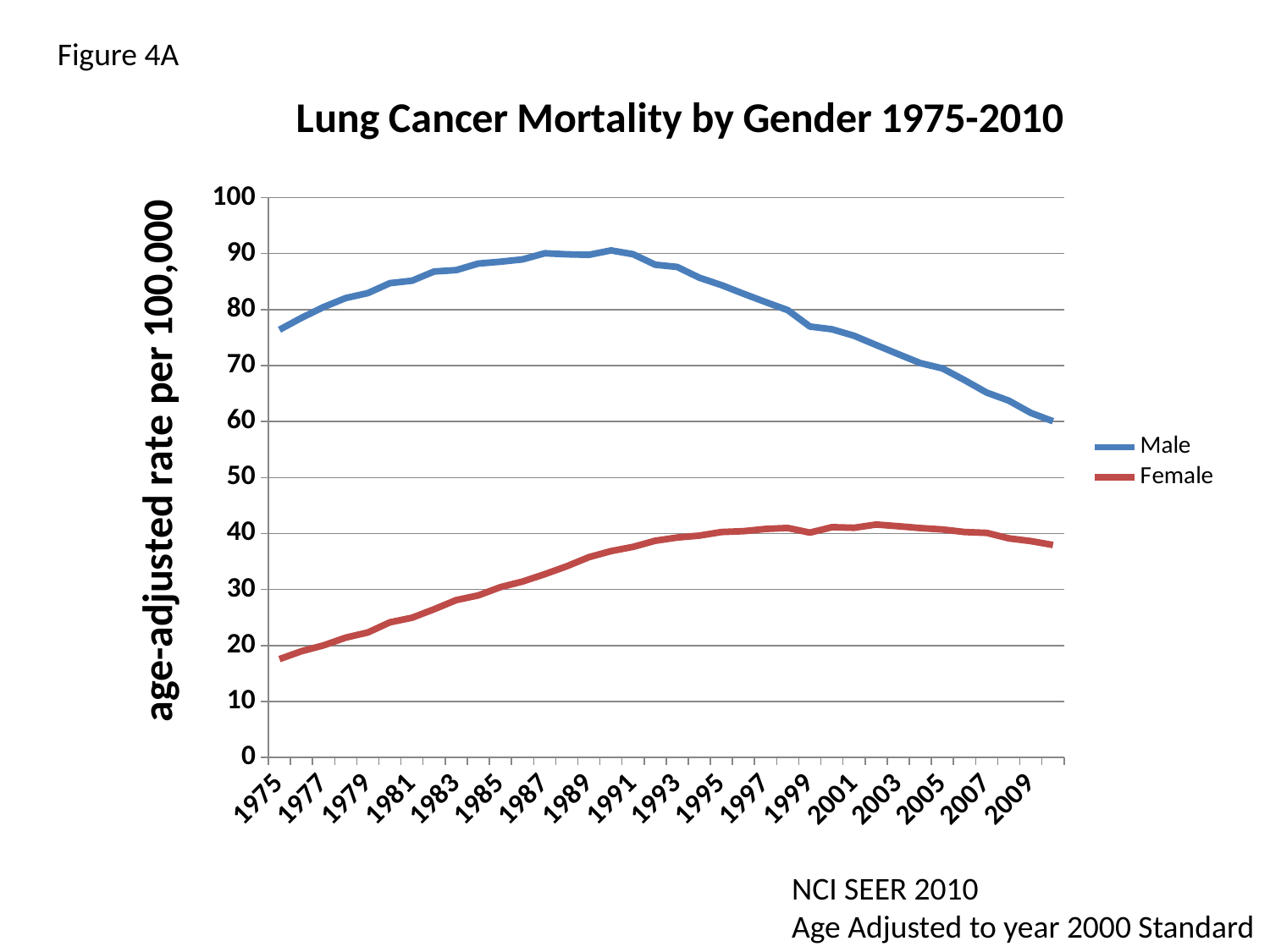
Is the Female value in 1975 greater or less than 20? less Does the Female line rise or fall between 1975 and 1990? rise What is the label on the vertical axis? age-adjusted rate per 100,000 Is the Male value in 1995 greater or less than 80? greater Is the Female value in 1980 greater or less than 20? greater How many series does the legend list? 2 What is the title of the chart? Lung Cancer Mortality by Gender 1975-2010 Does the Male line rise or fall between 1991 and 2010? fall What kind of chart is shown on the slide? line chart Which series has the higher value in 1975, Male or Female? Male